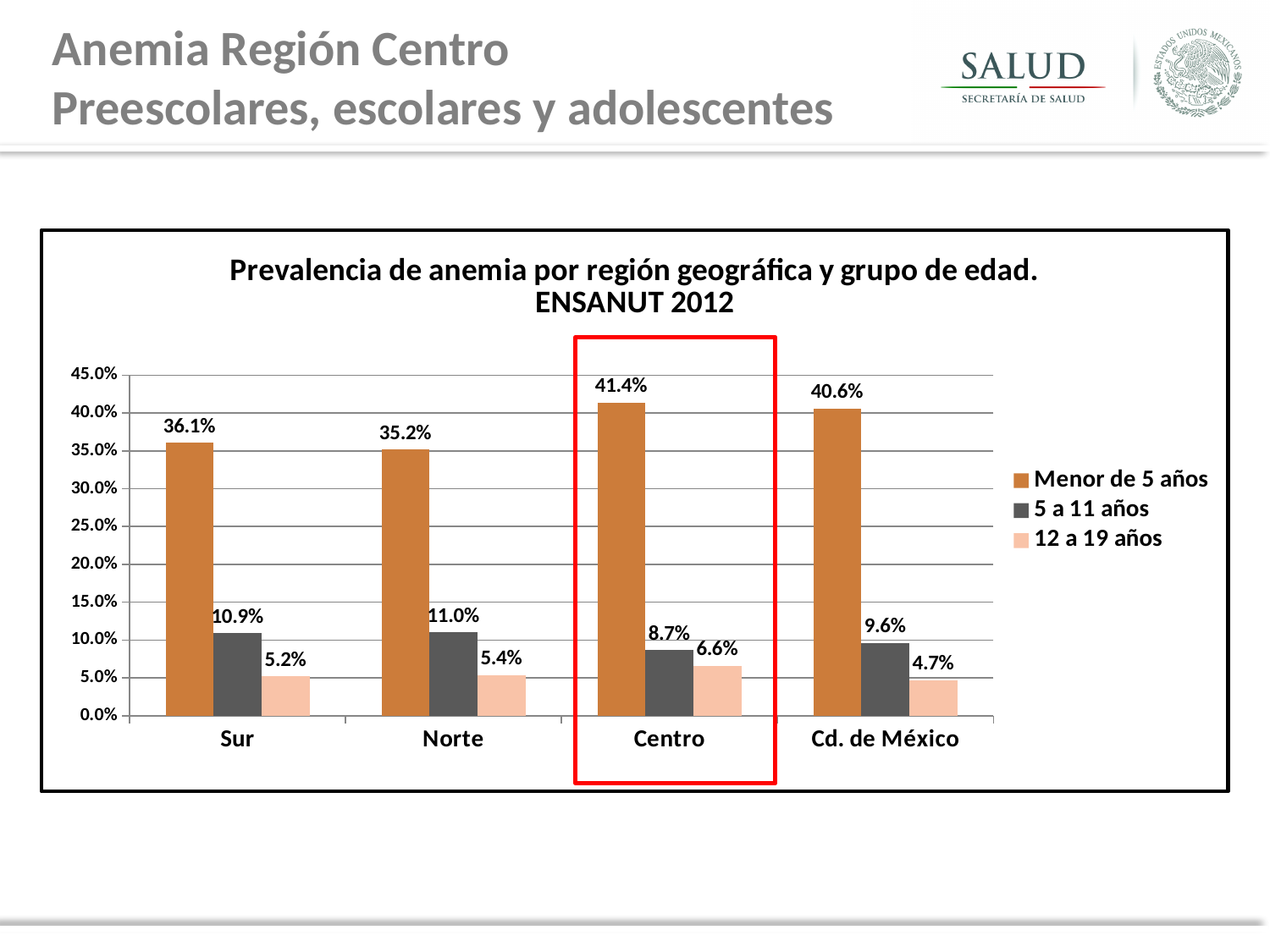
Which is larger: the '5 a 11 años' value for Sur or for Centro? Sur Which region has the lowest value for '12 a 19 años'? Cd. de México What kind of chart is shown on the slide? Bar chart What is the value for '12 a 19 años' in Cd. de México? 4.7% How many series does the legend list? 3 How many regions are shown on the x axis? 4 Is the value for 'Menor de 5 años' in Norte greater or less than 30.0%? greater Which region is highlighted with a red box on the chart? Centro Which region has the highest value for 'Menor de 5 años'? Centro What is the value for 'Menor de 5 años' in the Centro region? 41.4% What is the value for '5 a 11 años' in the Norte region? 11.0% What is the difference between the 'Menor de 5 años' values for Centro and Sur? 5.3%